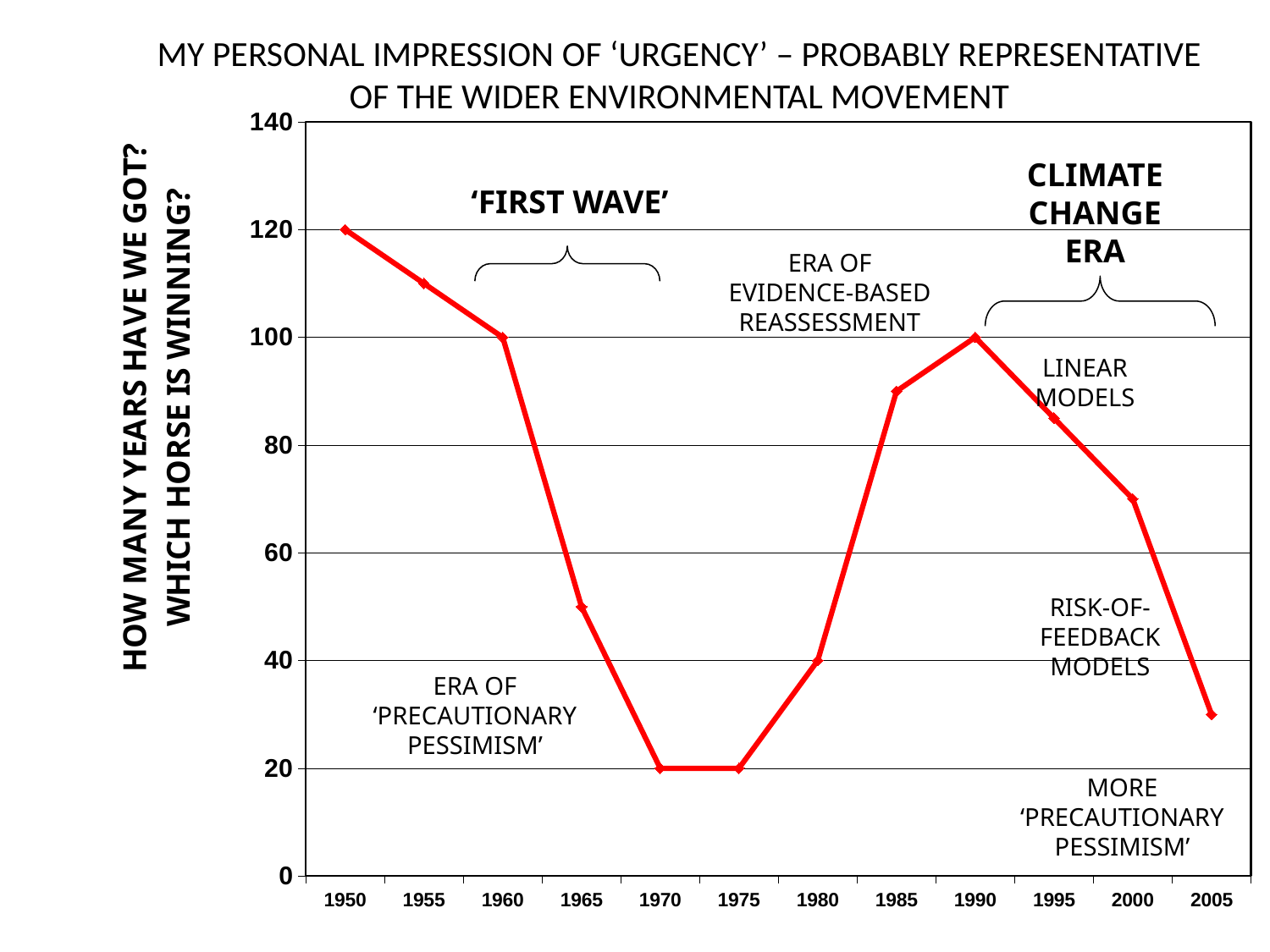
What is the value plotted for 1970? 20 What is the value plotted for 1990? 100 What is the value plotted for 1950? 120 What is the value plotted for 1960? 100 Which year has the highest value on the chart? 1950 Is the value for 1965 greater or less than 60? less What is the difference between the values for 1950 and 1990? 20 Is the value for 2005 greater or less than 40? less What is the value plotted for 1980? 40 What kind of chart is shown on the slide? line chart Which is larger, the value for 1980 or the value for 1985? 1985 How many years are marked on the x axis? 12